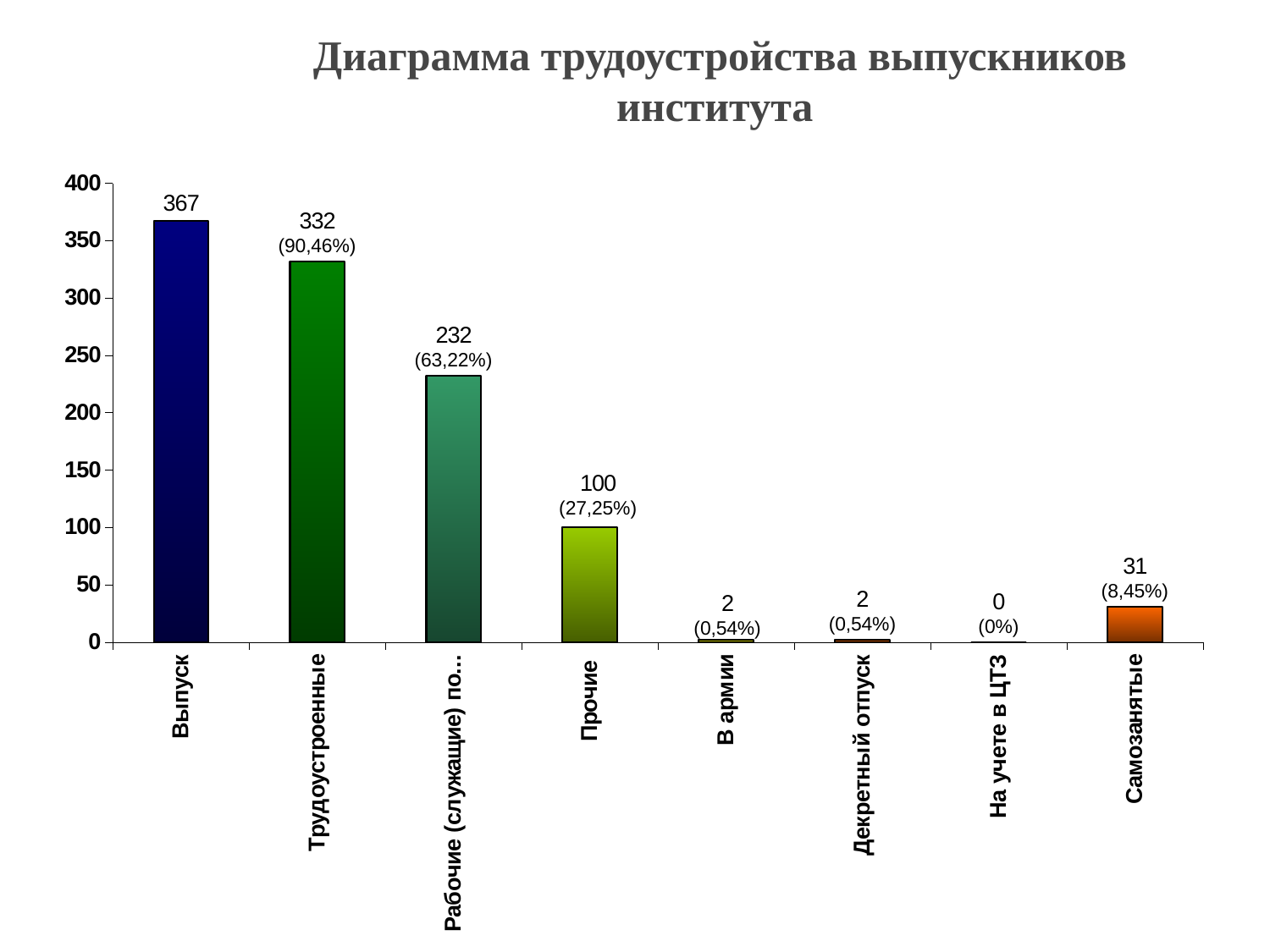
Which category has the highest value? Выпуск Which is larger, the value for Прочие or the value for Самозанятые? Прочие Which category has the lowest value? На учете в ЦТЗ What is the title of the chart? Диаграмма трудоустройства выпускников института What is the difference between the values for Выпуск and Трудоустроенные? 35 What kind of chart is this? Bar chart What is the value for Прочие? 100 What percentage is shown for Самозанятые? 8,45% What is the value for Самозанятые? 31 What is the value for Выпуск? 367 What is the value for Трудоустроенные? 332 How many categories are shown on the x axis? 8